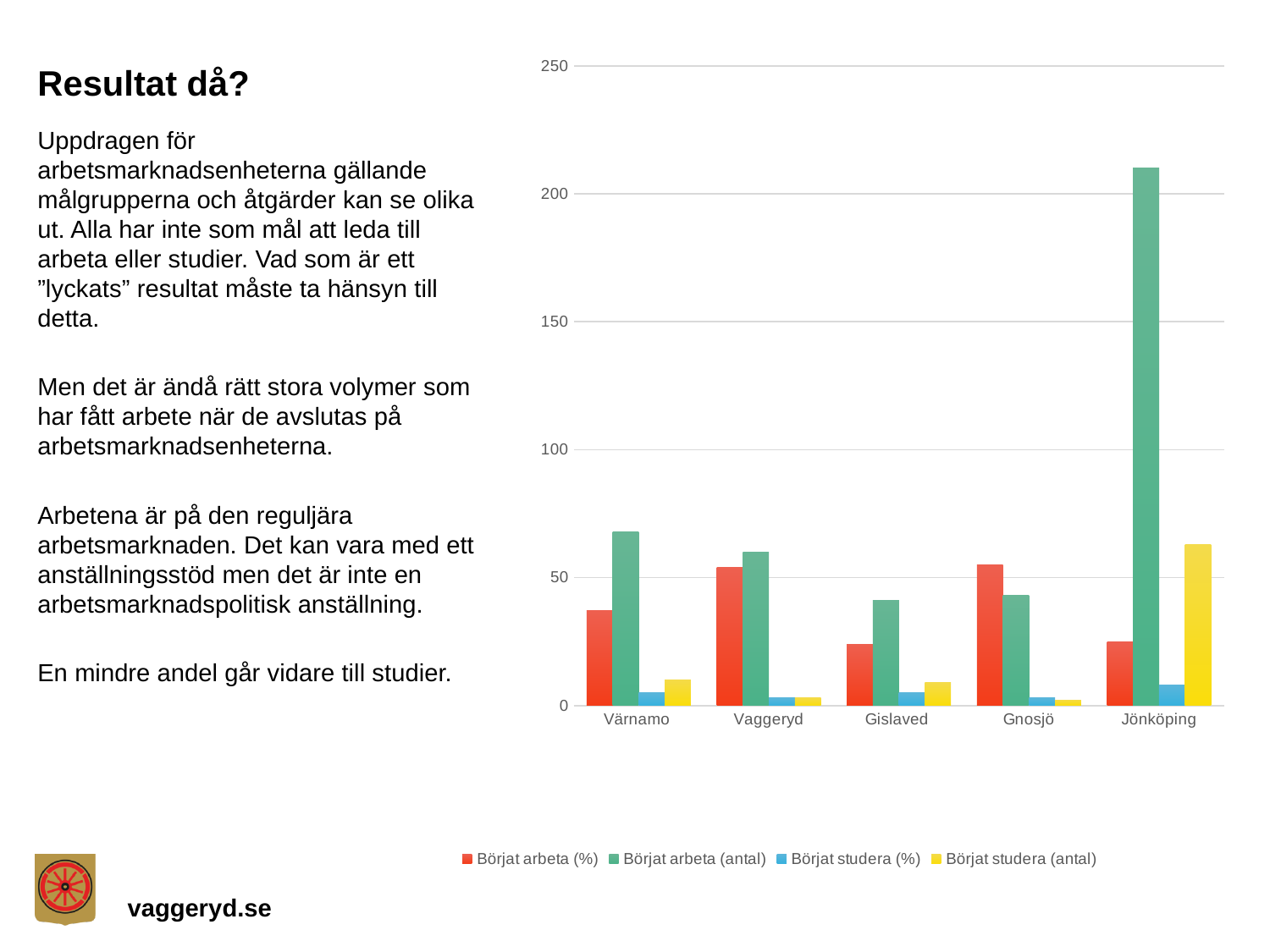
What kind of chart is shown on the slide? bar chart In Gnosjö, which is larger: Börjat arbeta (%) or Börjat arbeta (antal)? Börjat arbeta (%) Which municipality has the highest value for Börjat studera (antal)? Jönköping Is the value for Börjat arbeta (antal) in Jönköping greater or less than 200? greater How many municipalities are shown on the x axis of the chart? 5 Which colour represents Börjat studera (antal) in the chart's legend? yellow Which municipality has the highest value for Börjat arbeta (antal)? Jönköping Which is larger: Börjat arbeta (antal) in Jönköping or Börjat arbeta (antal) in Värnamo? Jönköping Is the value for Börjat arbeta (antal) in Gislaved greater or less than 50? less How many series does the chart's legend list? 4 Is the value for Börjat arbeta (%) in Värnamo greater or less than 50? less